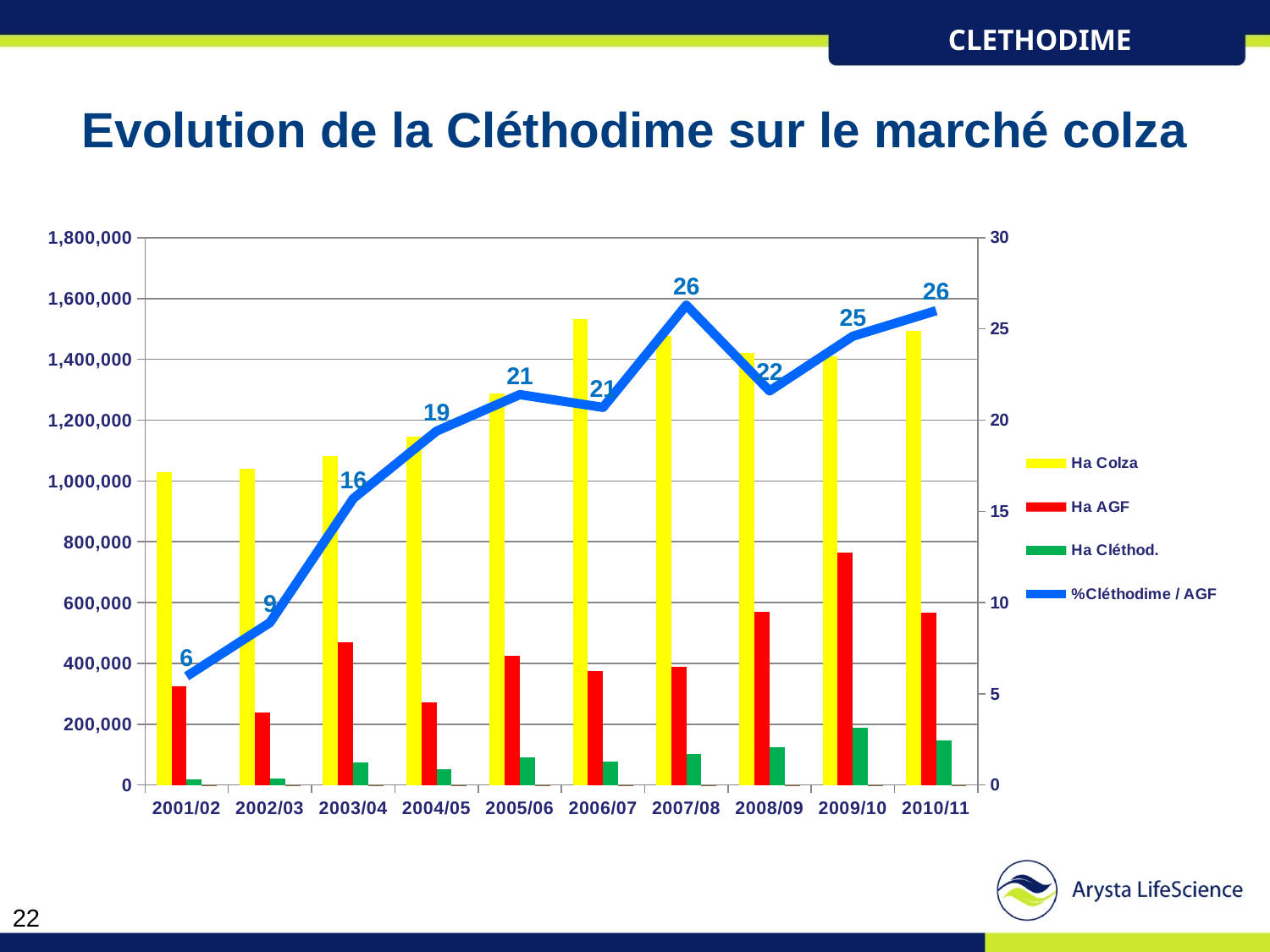
Which season has the higher %Cléthodime / AGF value, 2008/09 or 2009/10? 2009/10 What is the %Cléthodime / AGF value for 2001/02? 6 What is the difference between the %Cléthodime / AGF values for 2007/08 and 2001/02? 20 What is the %Cléthodime / AGF value for 2007/08? 26 Is the Ha AGF value for 2009/10 greater or less than 600,000? greater What is the %Cléthodime / AGF value for 2009/10? 25 How many seasons are shown on the x axis? 10 In which season is the %Cléthodime / AGF value lowest? 2001/02 Is the Ha Colza value for 2006/07 greater or less than 1,400,000? greater How many series does the legend list? 4 Does the %Cléthodime / AGF line generally rise or fall from 2001/02 to 2010/11? rise Is the Ha AGF value for 2002/03 greater or less than 400,000? less